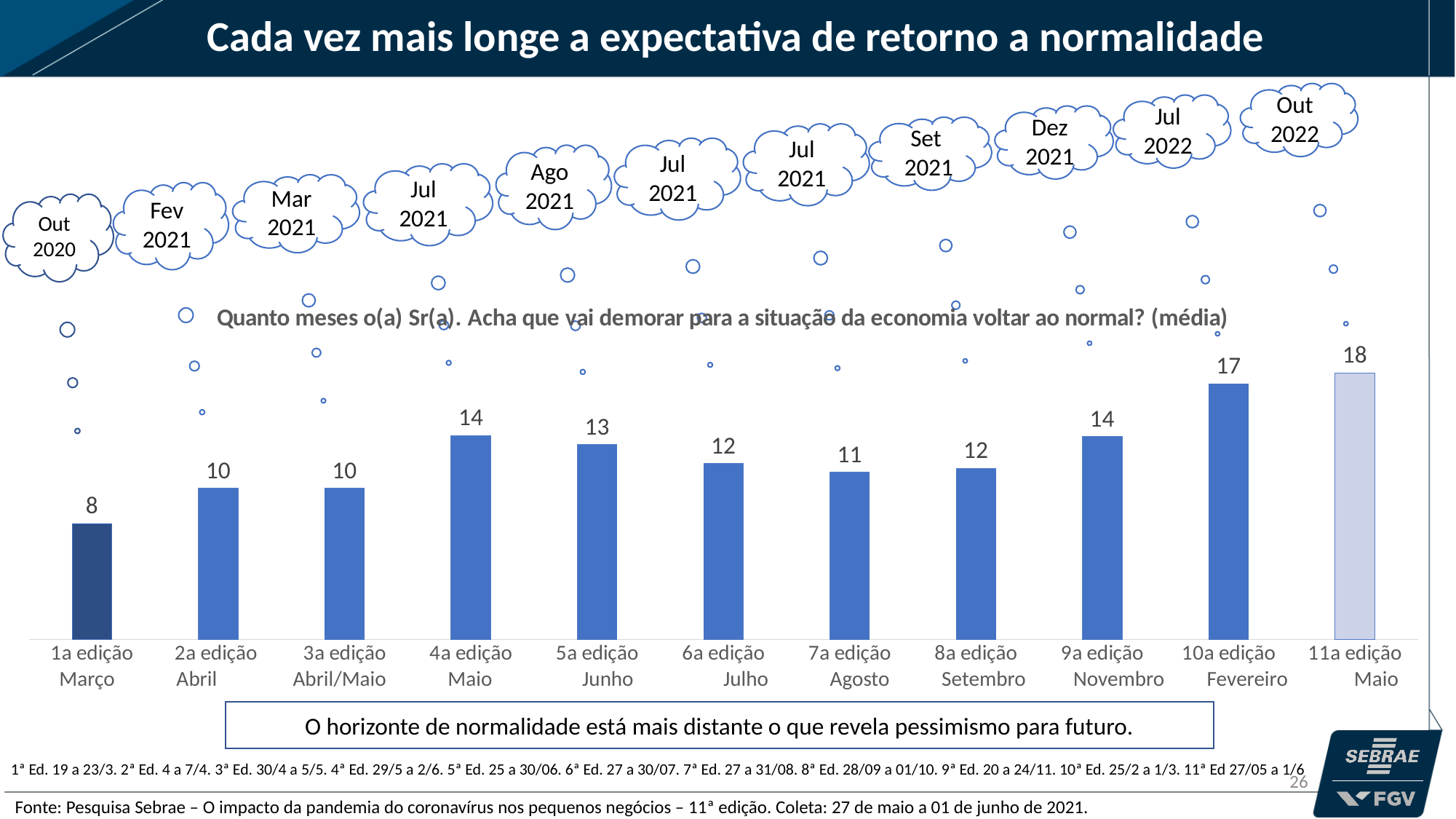
What is the value for 1a edição Março? 8 How many editions (bars) are shown in the chart? 11 Which is larger, the value for 4a edição Maio or the value for 6a edição Julho? 4a edição Maio What is the difference between the values for 11a edição Maio and 1a edição Março? 10 What is the value for 7a edição Agosto? 11 What is the value for 11a edição Maio? 18 What is the title of the chart? Quanto meses o(a) Sr(a). Acha que vai demorar para a situação da economia voltar ao normal? (média) Which edition has the lowest value? 1a edição Março What is the value for 5a edição Junho? 13 Do the values generally rise or fall from the 1a edição to the 11a edição? Rise What kind of chart is shown on the slide? Bar chart Which edition has the highest value? 11a edição Maio